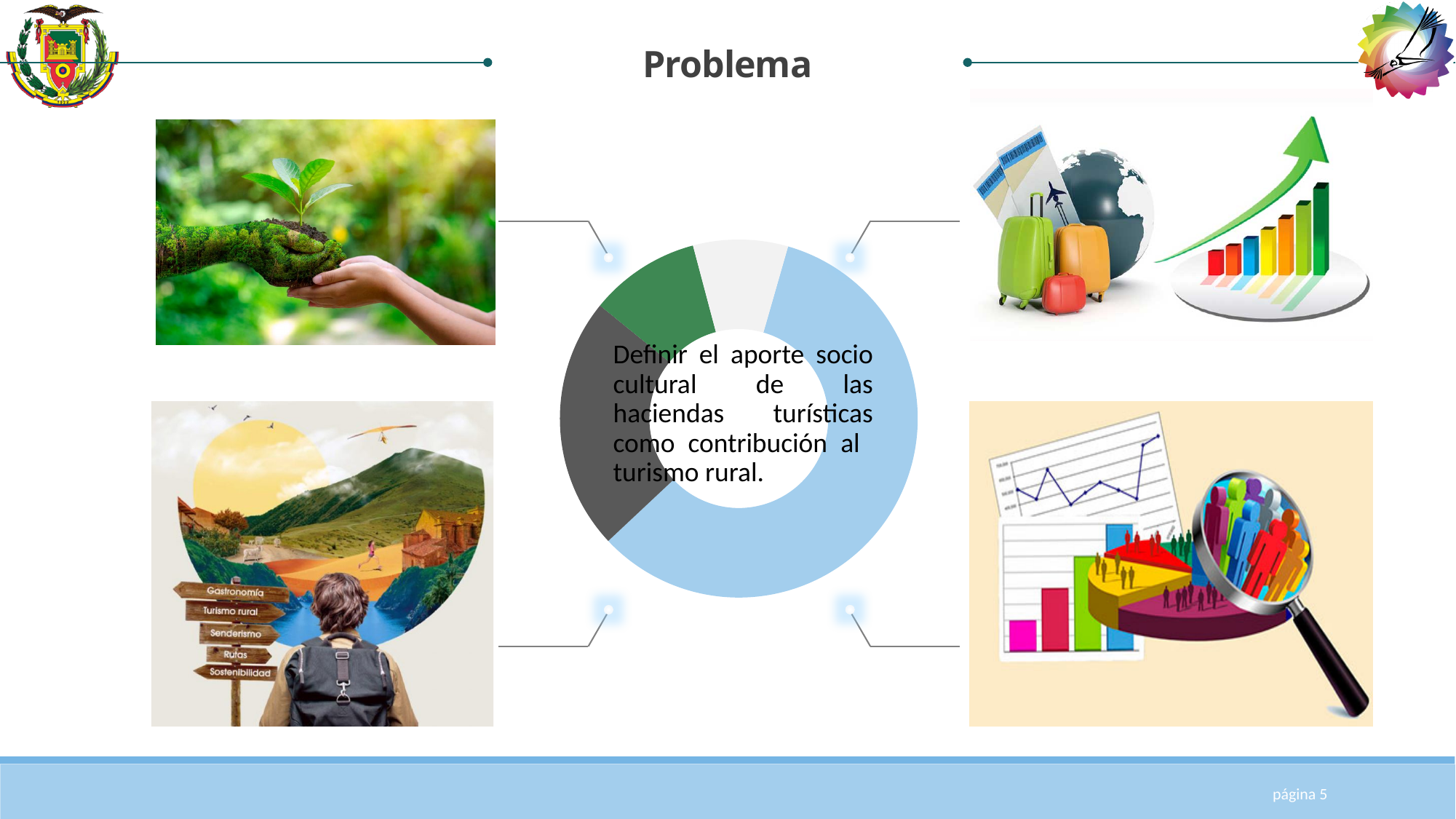
Is the light blue segment of the doughnut chart larger or smaller than the dark grey segment? Larger Which colour segment of the doughnut chart is the largest? Light blue How many segments does the doughnut chart in the centre of the slide have? 4 Does the doughnut chart in the centre of the slide show any data labels or a legend? No What is the title of the slide containing the doughnut chart? Problema What kind of chart is shown in the centre of the slide? Doughnut (pie) chart